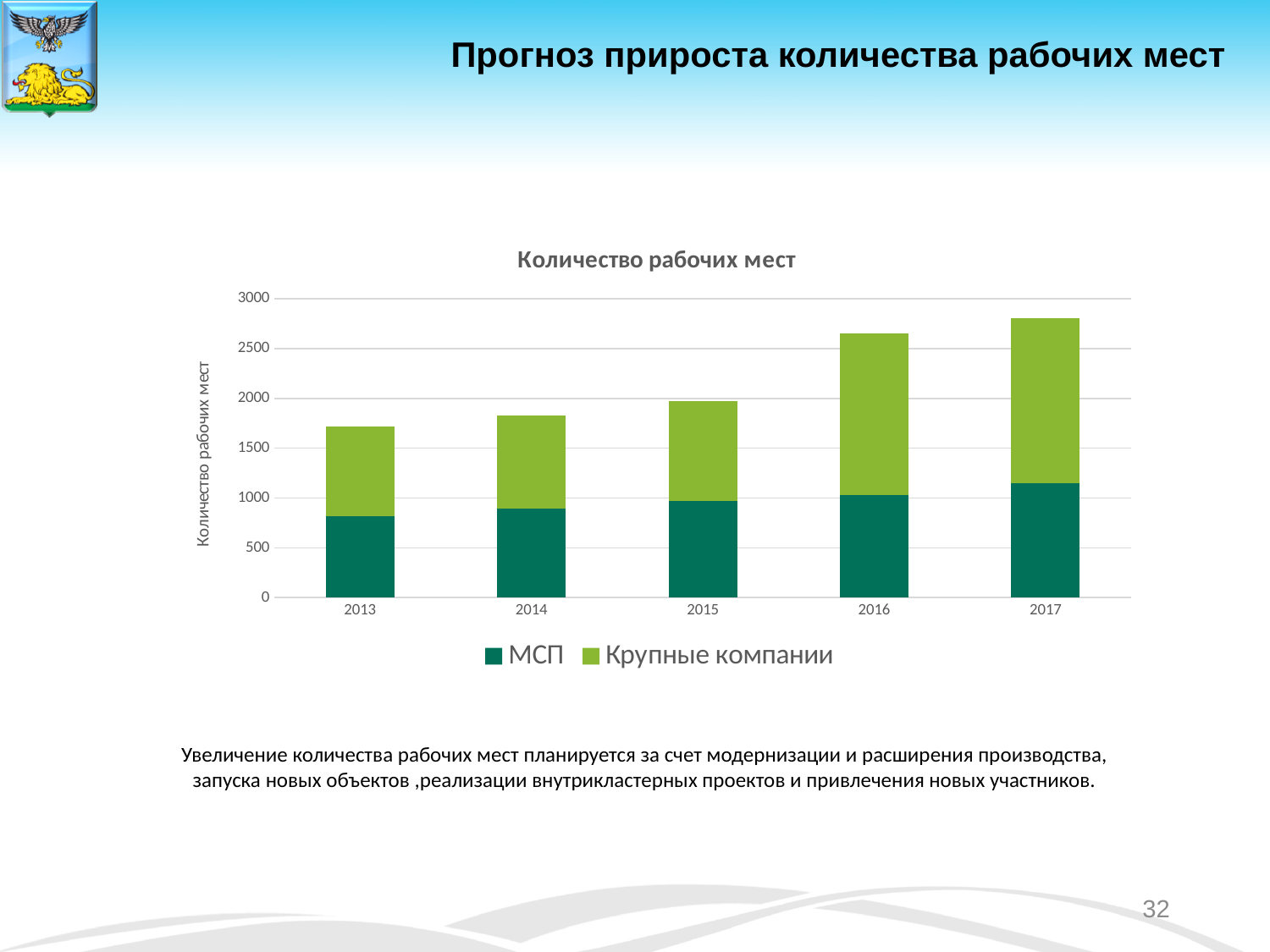
How many series does the chart legend list? 2 What is the title of the chart? Количество рабочих мест What kind of chart is shown on the slide? Stacked bar chart Which year has the lowest total number of jobs in the chart? 2013 Is the total value for 2017 greater or less than 2500? greater How many years are shown on the x axis of the chart? 5 Is the total value for 2016 greater or less than 2500? greater Is the МСП value for 2013 greater or less than 1000? less Which series is shown in dark green in the chart? МСП Which year has the highest total number of jobs in the chart? 2017 Do the total bar heights rise or fall from 2013 to 2017? Rise